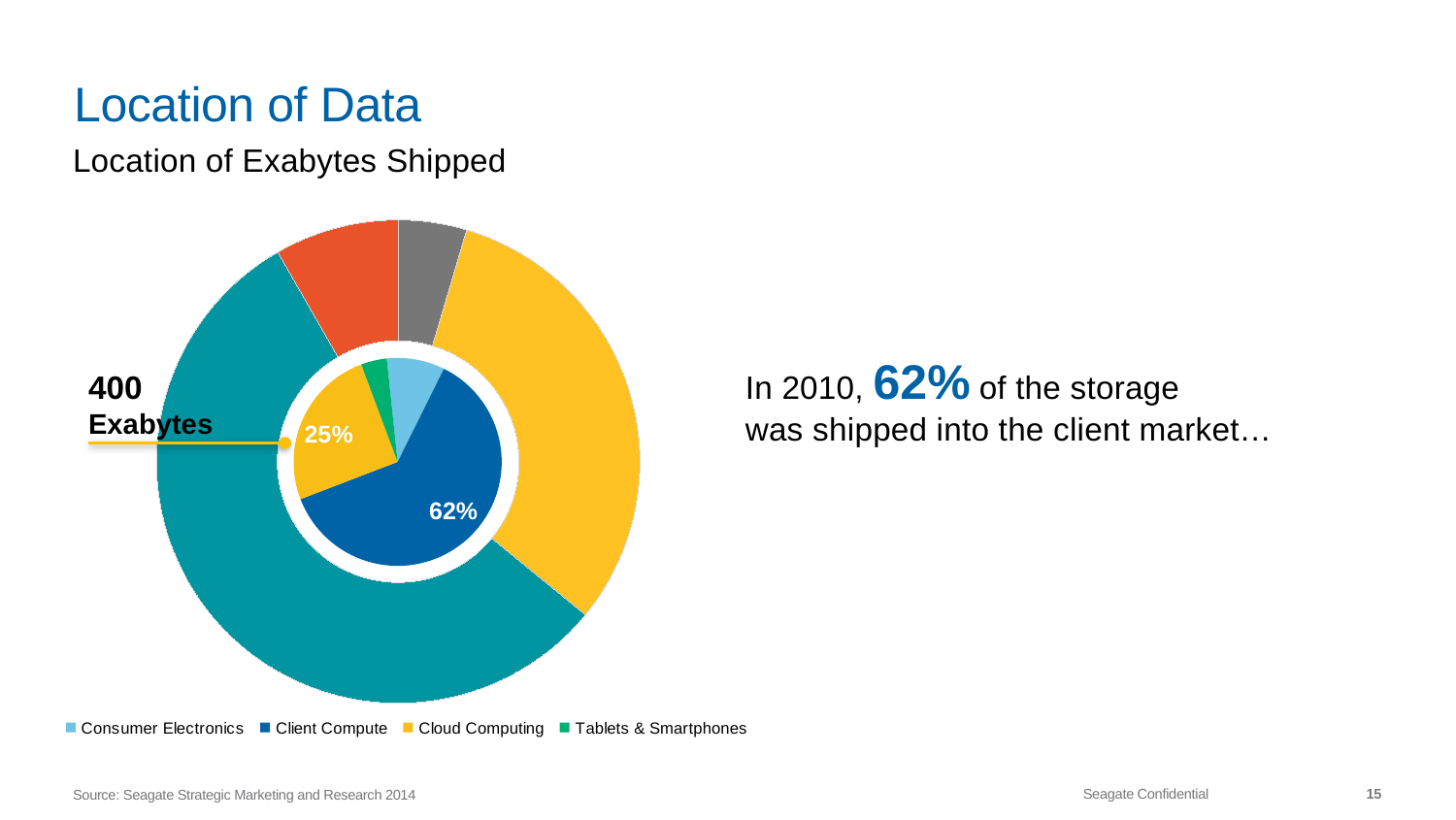
In the inner pie, which is larger: the Client Compute share or the Cloud Computing share? Client Compute What is the subtitle of the chart on the slide? Location of Exabytes Shipped Is the Client Compute share in the inner pie greater or less than 50%? greater In the inner pie, what share is labelled for Client Compute? 62% How many entries does the chart legend list? 4 In the inner pie, what share is labelled for Cloud Computing? 25% In the inner pie, by how many percentage points does the Client Compute share exceed the Cloud Computing share? 37 percentage points In the inner pie, which category has the smallest share? Tablets & Smartphones What total amount is labelled next to the inner pie? 400 Exabytes What kind of chart is shown on the slide? pie chart In the inner pie, which category has the largest share? Client Compute